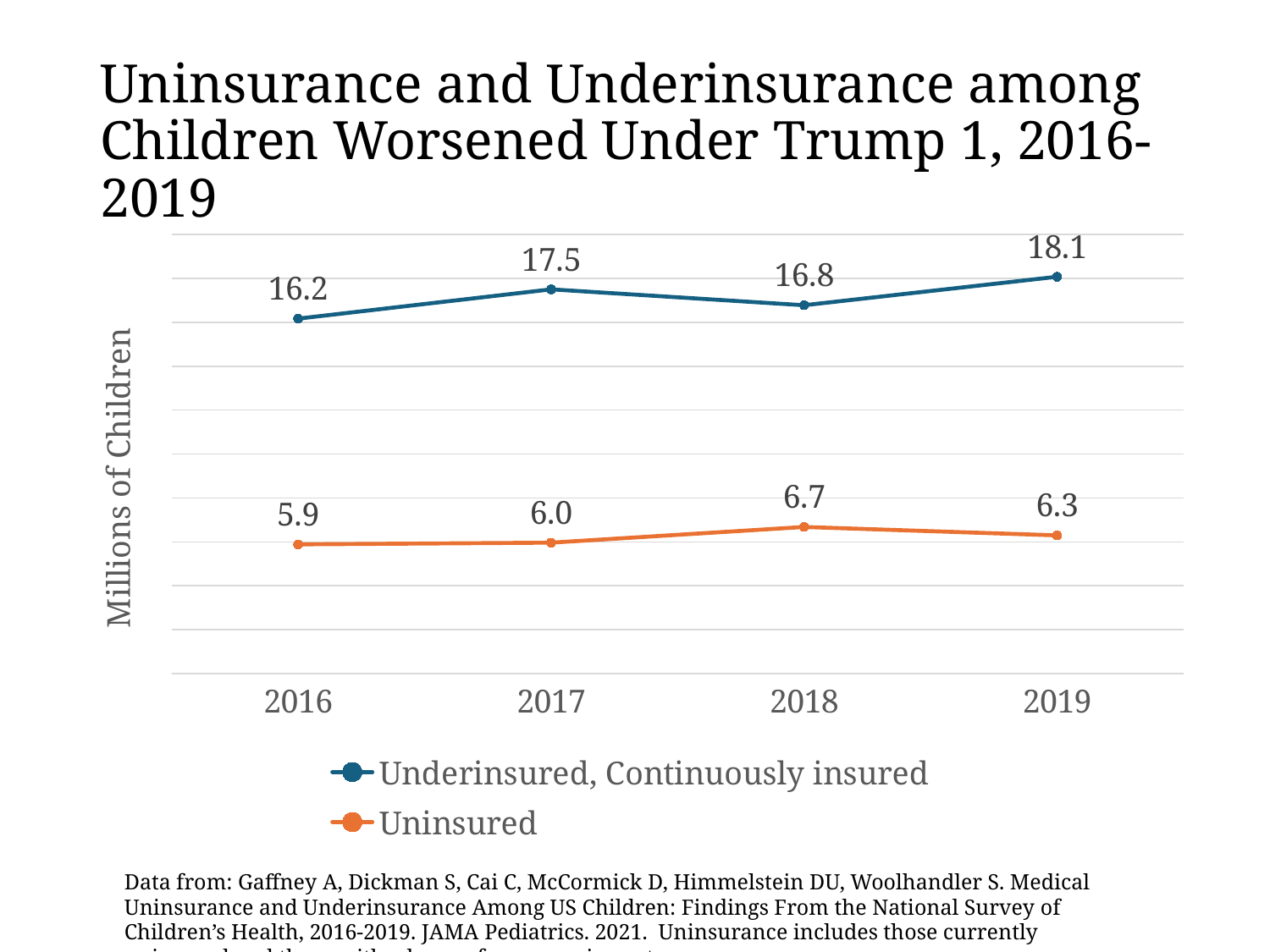
What kind of chart is shown on the slide? line chart In which year is the Underinsured, Continuously insured series lowest? 2016 Does the Underinsured, Continuously insured series rise or fall from 2017 to 2018? fall What is the label on the y axis? Millions of Children What is the difference between the Underinsured, Continuously insured values in 2019 and 2016? 1.9 Which is larger, the Uninsured value in 2017 or in 2019? 2019 What is the value for Underinsured, Continuously insured in 2019? 18.1 What is the value for Underinsured, Continuously insured in 2016? 16.2 How many series does the legend list? 2 In which year is the Uninsured series highest? 2018 What is the value for Uninsured in 2018? 6.7 How many years are plotted on the x axis? 4